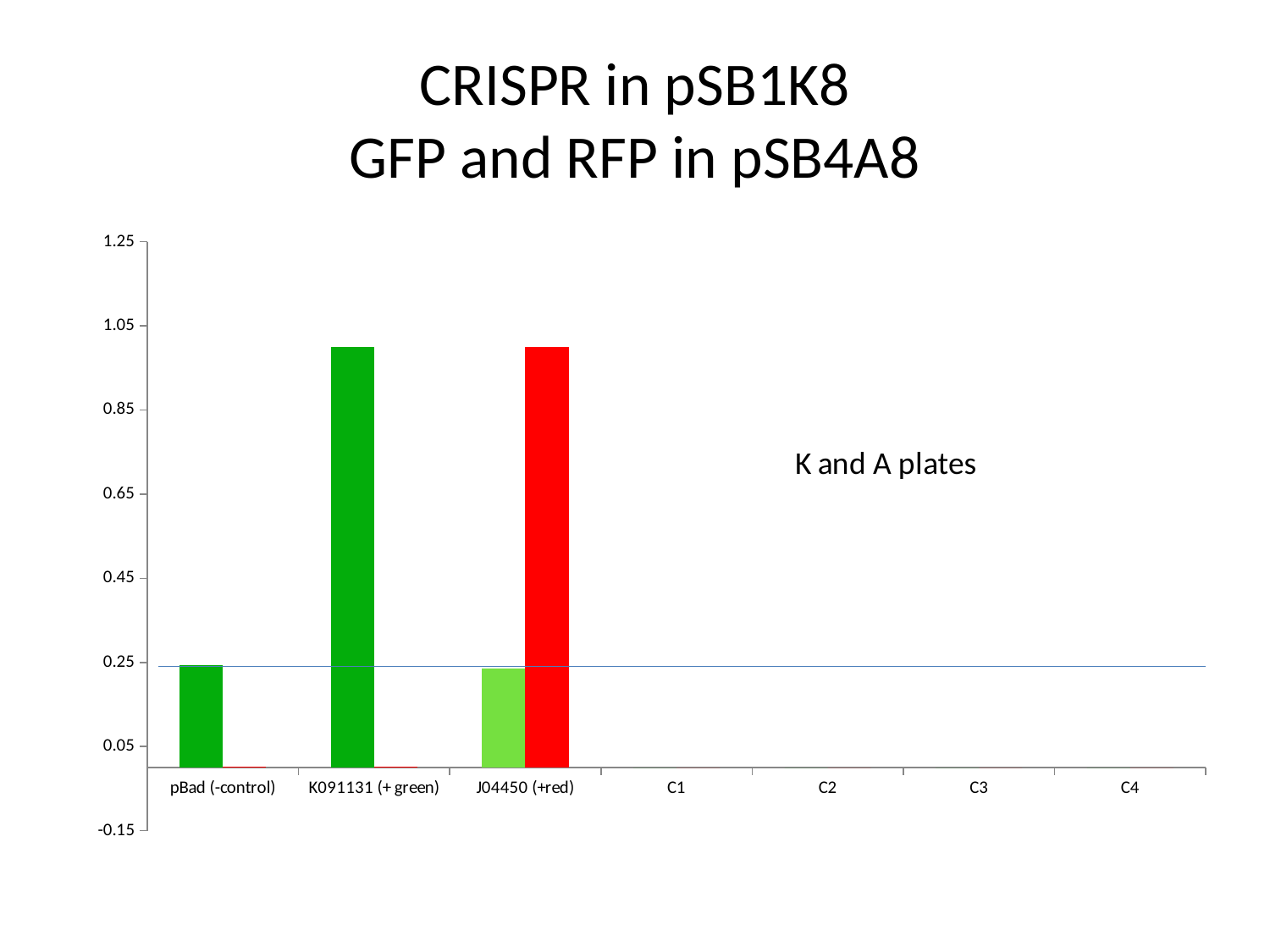
Which is larger, the green bar for K091131 (+ green) or the green bar for pBad (-control)? K091131 (+ green) Is the green bar for K091131 (+ green) greater or less than 0.85? greater What kind of chart is shown on the slide? bar chart What text annotation appears inside the chart area? K and A plates For J04450 (+red), which is larger, the red bar or the green bar? the red bar Is the red bar for J04450 (+red) greater or less than 0.85? greater What is the title shown at the top of the slide? CRISPR in pSB1K8 GFP and RFP in pSB4A8 Which category has the tallest red bar? J04450 (+red) Is the green bar for pBad (-control) greater or less than 0.45? less Which category has the tallest green bar? K091131 (+ green) How many categories are labelled on the x axis? 7